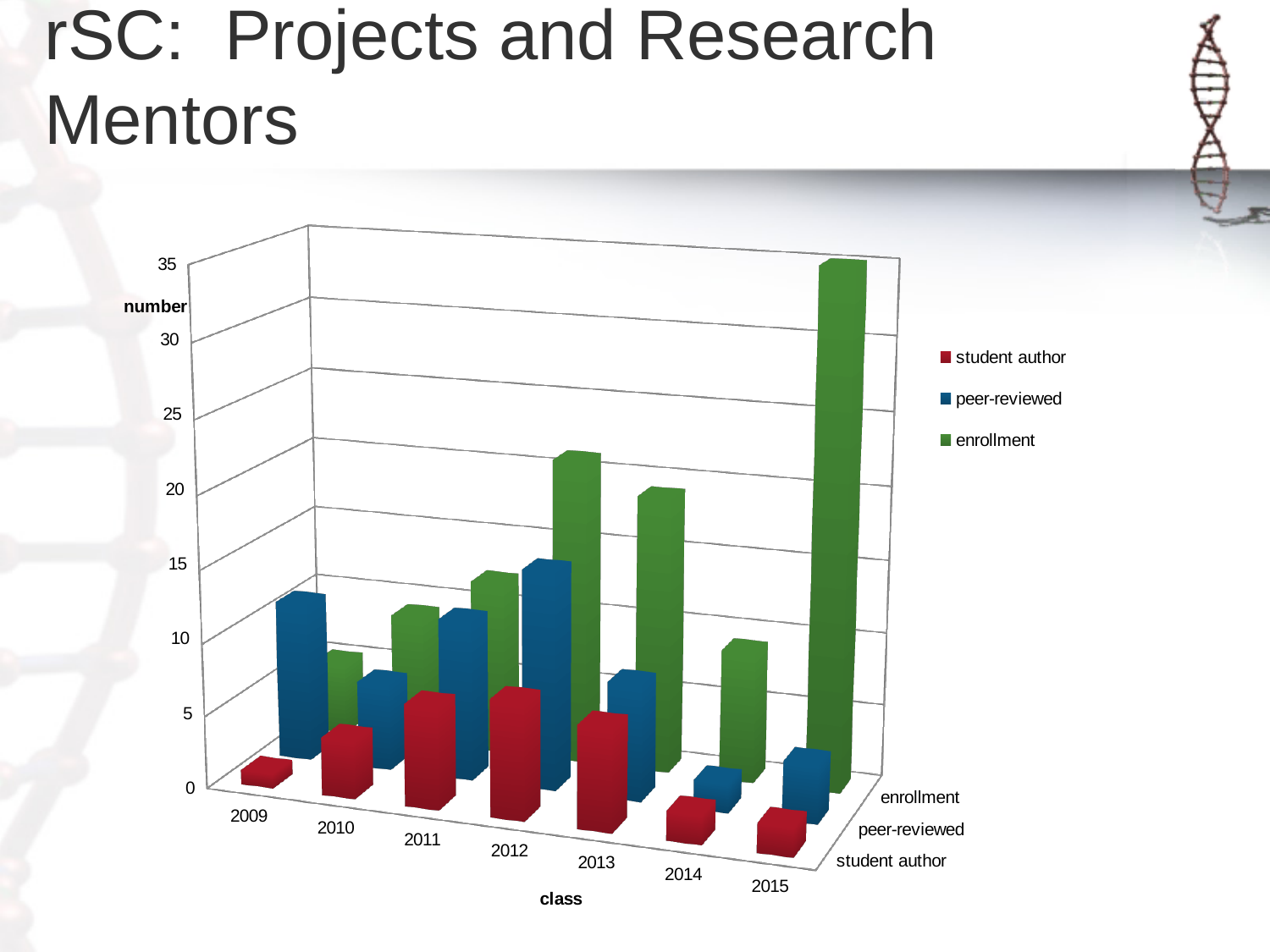
How many series does the legend list? 3 Is the student author value for 2009 greater or less than 5? less Is the peer-reviewed value for 2014 greater or less than 5? less Which class has the highest enrollment? 2015 What kind of chart is shown on the slide? bar chart Which class has the lowest peer-reviewed value? 2014 Which is larger, the peer-reviewed value for 2009 or for 2014? 2009 Which is larger, the enrollment for 2015 or the enrollment for 2013? 2015 Is the enrollment value for 2015 greater or less than 30? greater Which class has the lowest number of student authors? 2009 What is the title of the vertical axis? number How many classes (years) are shown on the x axis? 7